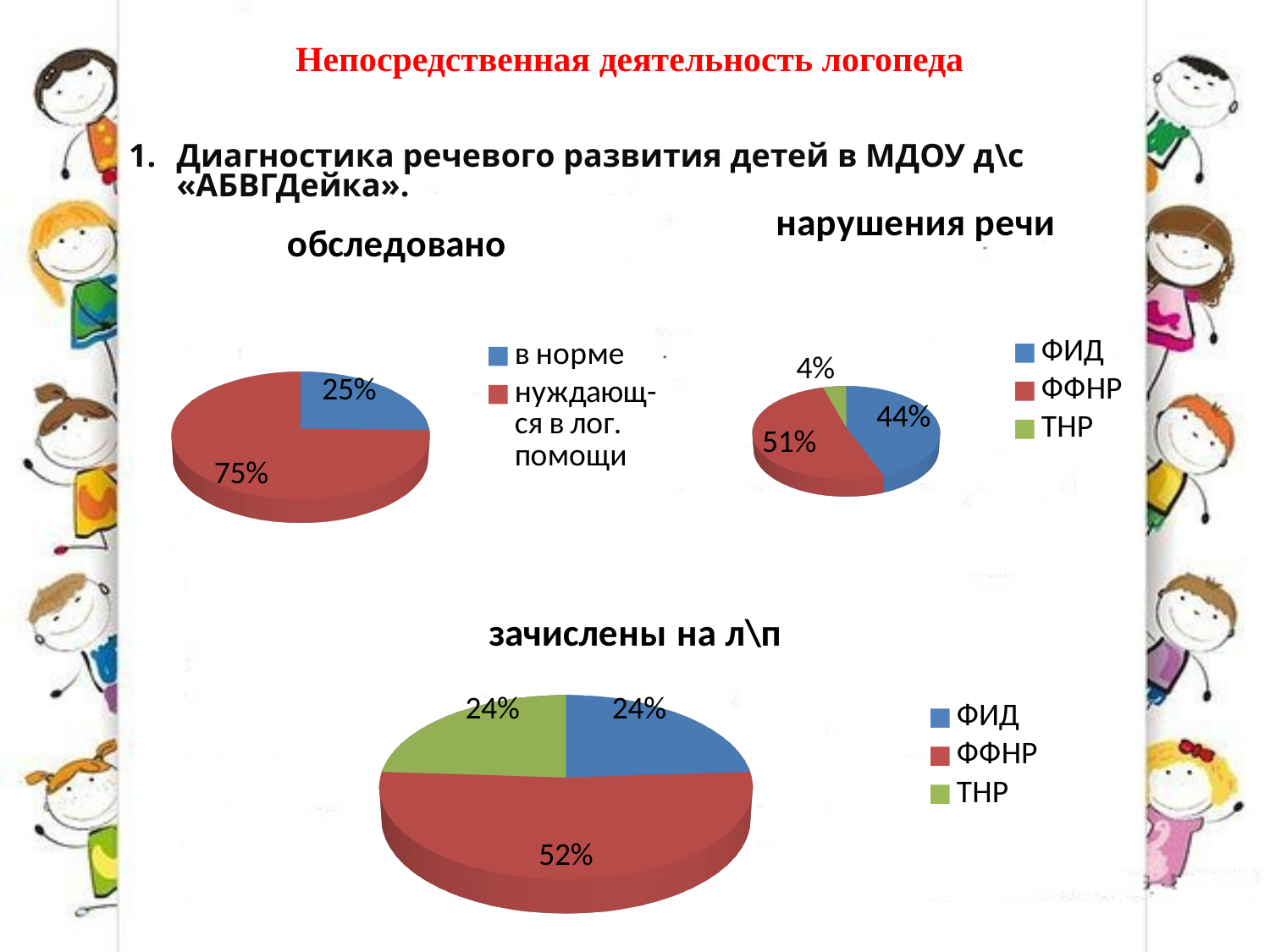
In the chart titled «нарушения речи», which category has the smallest share? ТНР What type of chart is used for «обследовано»? Pie chart In the chart titled «обследовано», what share is labelled «в норме»? 25% How many entries does the legend of the chart titled «нарушения речи» list? 3 In the chart titled «обследовано», what share is labelled «нуждающ-ся в лог. помощи»? 75% In the chart titled «нарушения речи», what is the difference between the ФФНР and ФИД shares? 7% In the chart titled «зачислены на л\п», which category has the largest share? ФФНР In the chart titled «нарушения речи», what share does ФФНР have? 51% In the chart titled «зачислены на л\п», what share does ФФНР have? 52% In the chart titled «нарушения речи», what share does ТНР have? 4% In the chart titled «зачислены на л\п», how many slices does the pie have? 3 In the chart titled «обследовано», which category has the larger share? нуждающ-ся в лог. помощи